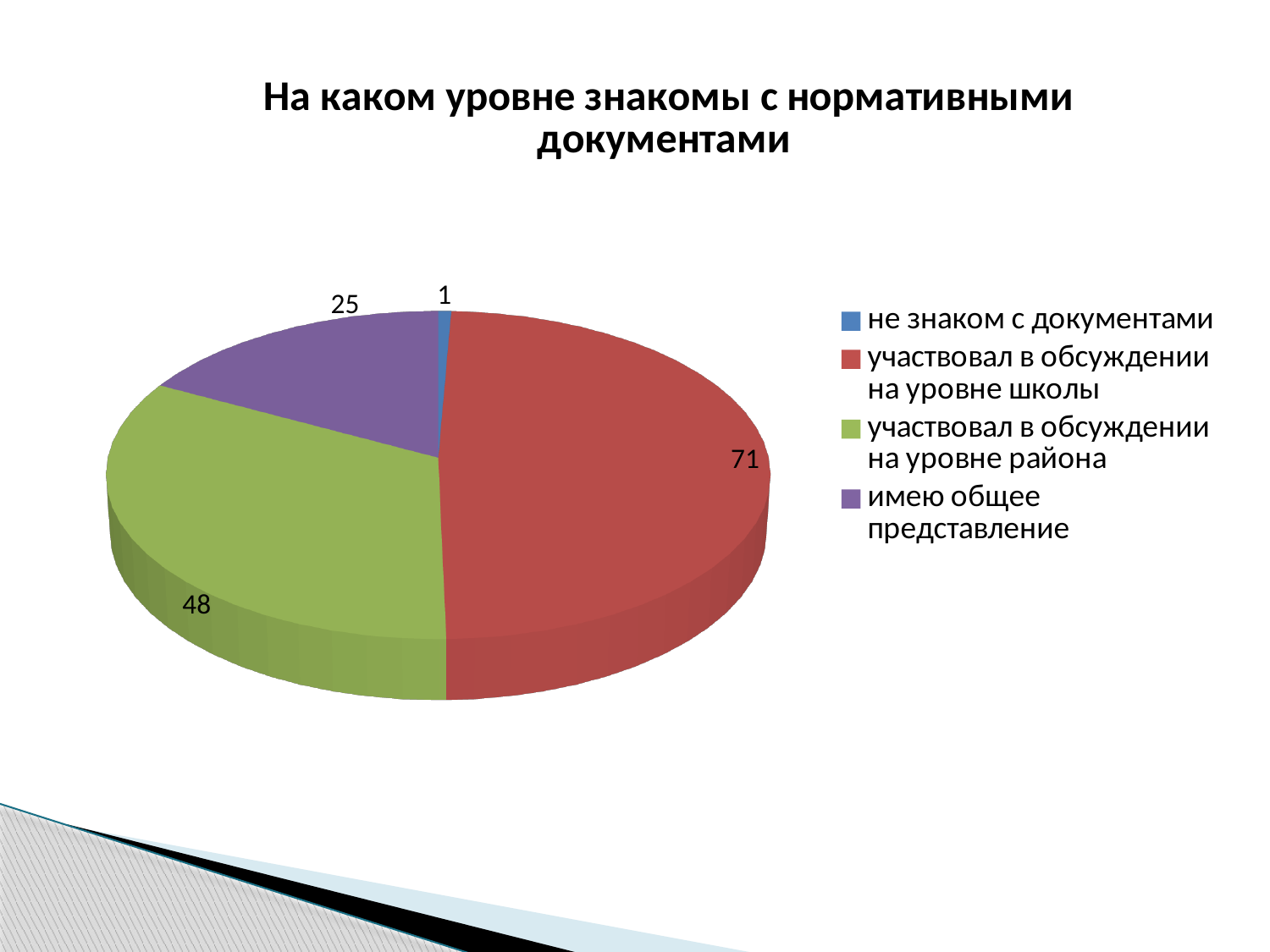
What is the value for "участвовал в обсуждении на уровне школы"? 71 What is the title of the chart? На каком уровне знакомы с нормативными документами What type of chart is shown on the slide? pie chart What is the total of all the values shown in the pie chart? 145 Which is larger: the value for "участвовал в обсуждении на уровне района" or the value for "имею общее представление"? участвовал в обсуждении на уровне района What is the difference between the values for "участвовал в обсуждении на уровне школы" and "участвовал в обсуждении на уровне района"? 23 Which category has the largest slice of the pie? участвовал в обсуждении на уровне школы What is the value for "имею общее представление"? 25 How many categories does the pie chart have? 4 What is the value for "участвовал в обсуждении на уровне района"? 48 What is the value for "не знаком с документами"? 1 Which category has the smallest slice of the pie? не знаком с документами